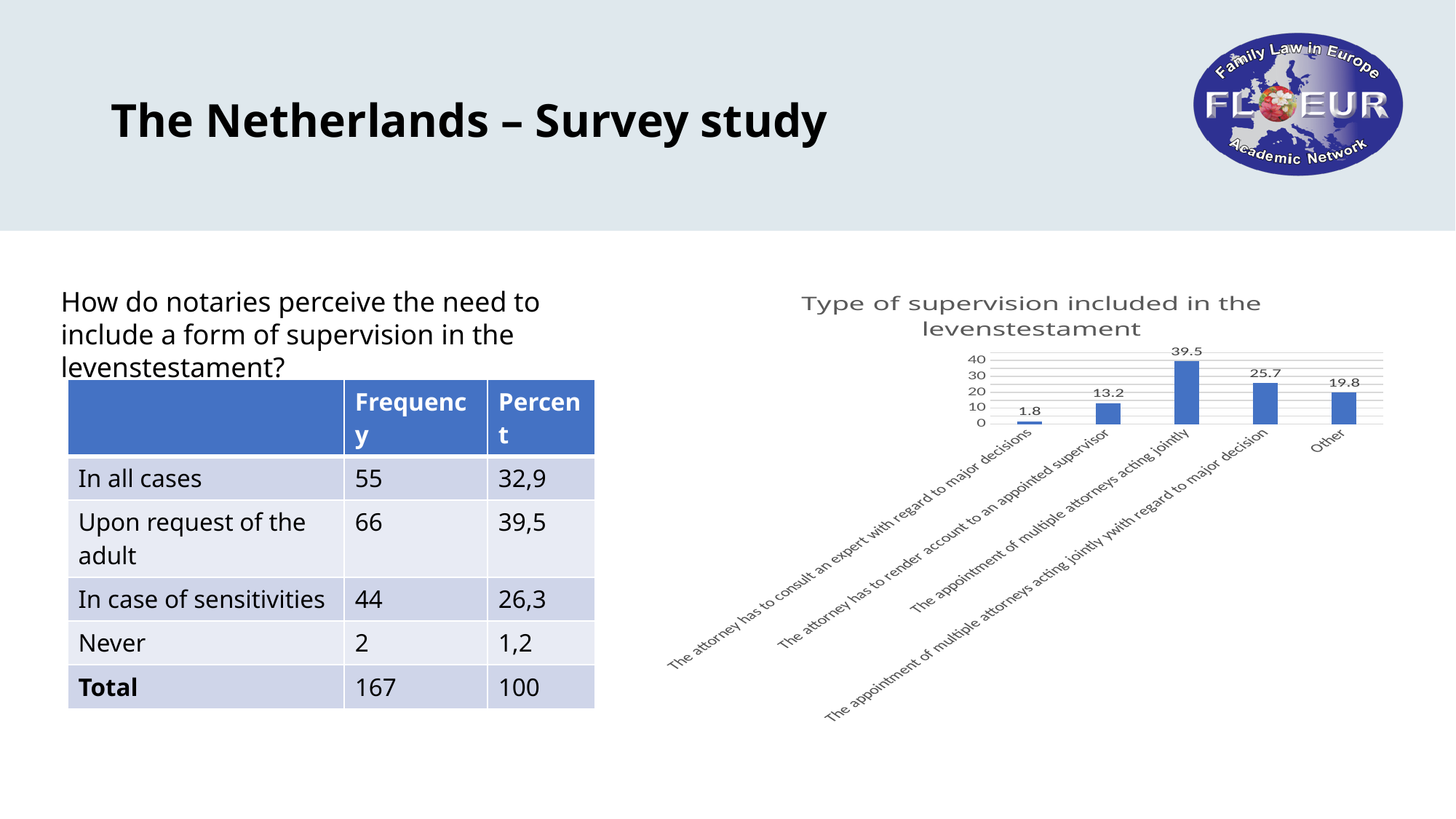
What is the value for 'Other' in the chart? 19.8 What is the value for 'The appointment of multiple attorneys acting jointly' in the chart? 39.5 Which category has the highest value in the chart? The appointment of multiple attorneys acting jointly What kind of chart is shown on the slide? bar chart What is the difference between the values for 'The appointment of multiple attorneys acting jointly' and 'Other'? 19.7 Is the value for 'The attorney has to render account to an appointed supervisor' greater or less than 20? less Which is larger: the value for 'The appointment of multiple attorneys acting jointly with regard to major decision' or the value for 'Other'? The appointment of multiple attorneys acting jointly with regard to major decision What is the value for 'The attorney has to render account to an appointed supervisor' in the chart? 13.2 How many categories are shown in the chart? 5 What is the value for 'The attorney has to consult an expert with regard to major decisions' in the chart? 1.8 What is the title of the chart? Type of supervision included in the levenstestament Which category has the lowest value in the chart? The attorney has to consult an expert with regard to major decisions